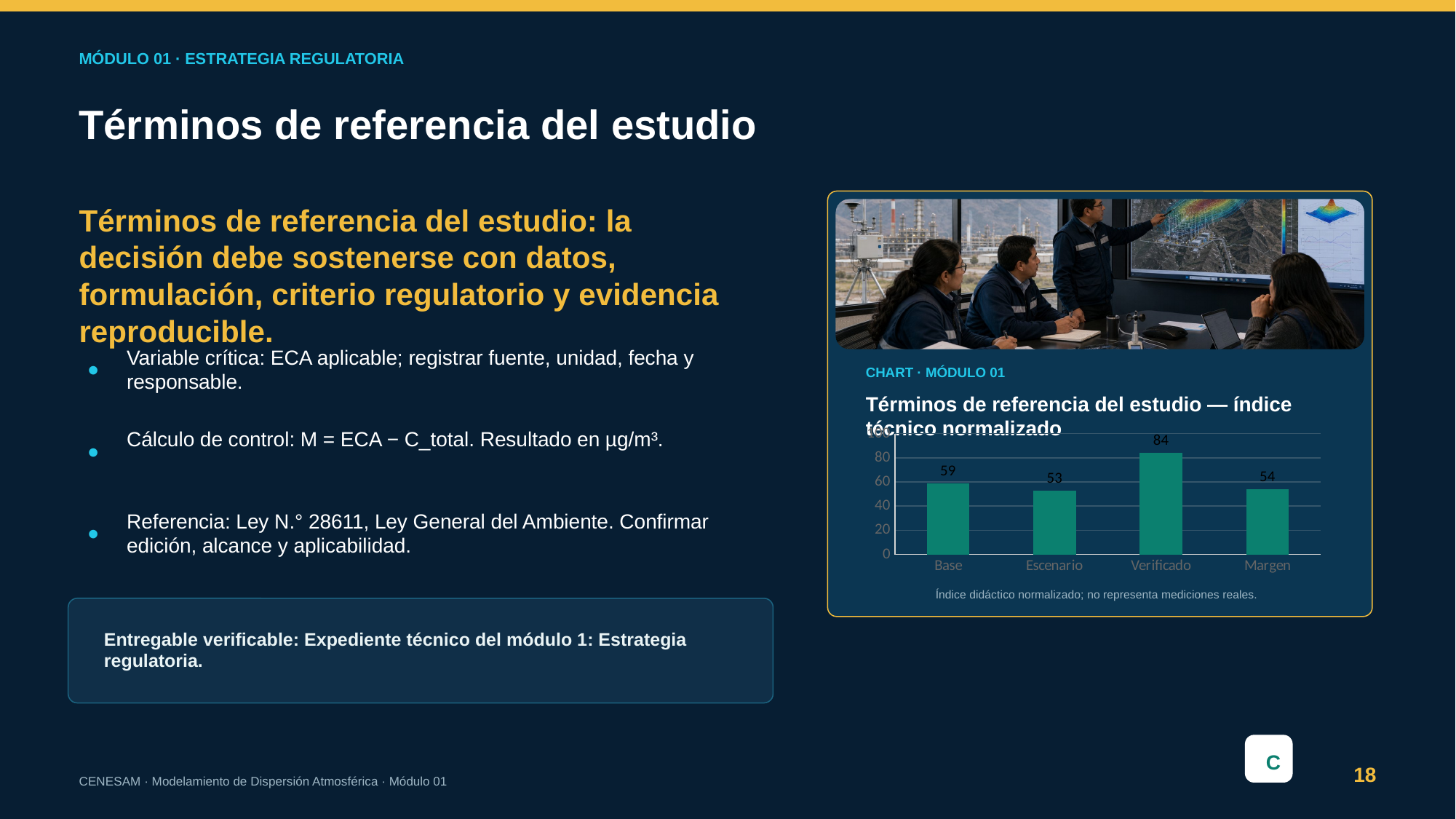
What kind of chart is shown on the slide? bar chart What is the difference between the values for Base and Escenario? 6 What is the value for Margen? 54 What is the value for Verificado? 84 Which category has the highest value? Verificado What is the value for Escenario? 53 What is the title of the chart? Términos de referencia del estudio — índice técnico normalizado Which is larger, the value for Verificado or the value for Margen? Verificado Is the value for Verificado greater or less than 80? greater What is the difference between the values for Verificado and Base? 25 What is the value for Base? 59 How many categories are shown on the x axis? 4